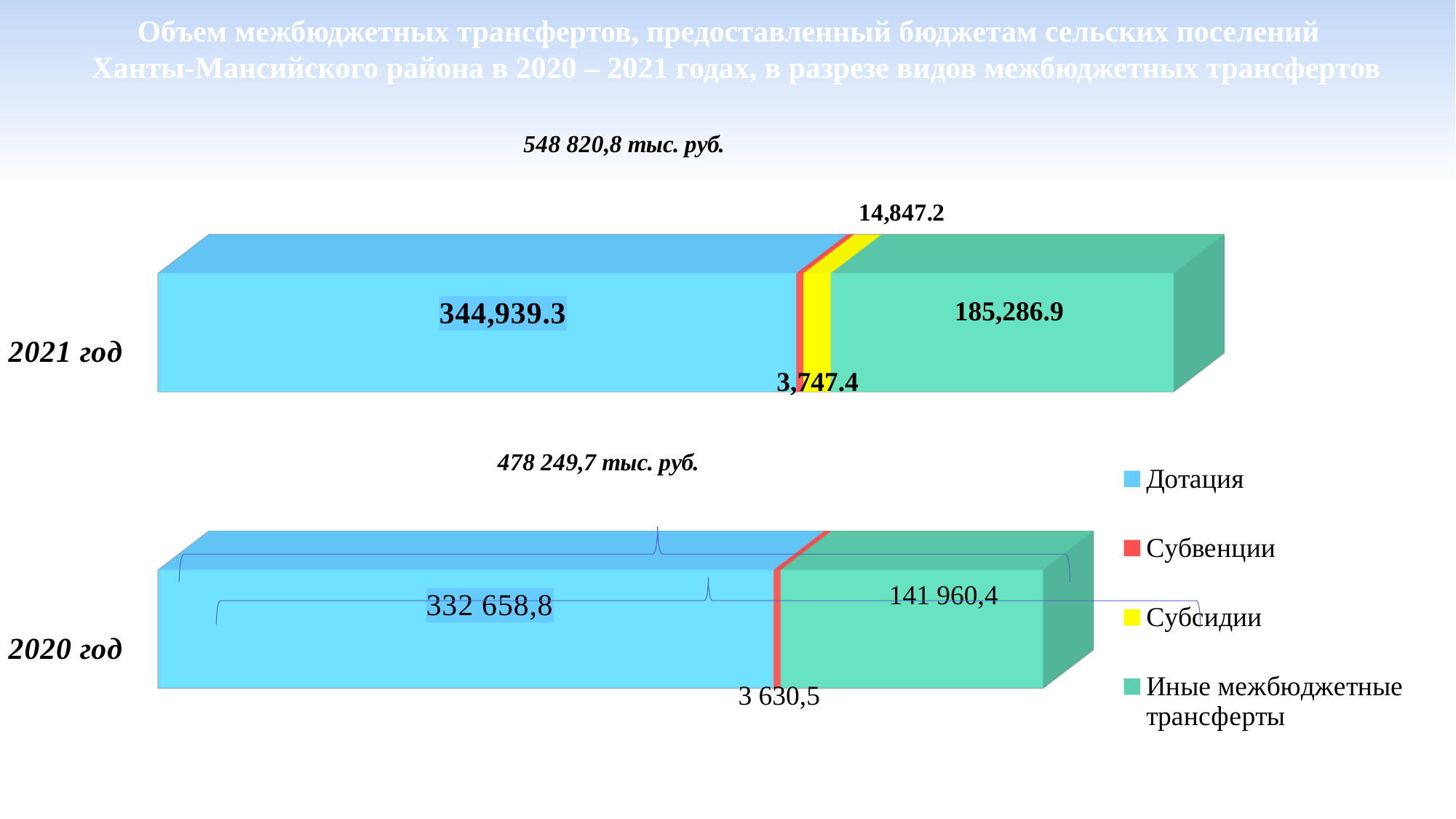
In the 2021 год chart, what is the value for Дотация? 344,939.3 How many series does the legend list? 4 In the 2020 год chart, what is the value for Субвенции? 3 630,5 Which is larger: Дотация in 2021 год or Дотация in 2020 год? Дотация in 2021 год In the 2020 год chart, what is the value for Иные межбюджетные трансферты? 141 960,4 What is the total of the 2020 год stacked bar? 478 249,7 тыс. руб. What kind of chart is used on this slide? Stacked bar chart In the 2021 год chart, what is the value for Субсидии? 14,847.2 In the 2021 год chart, which transfer type has the largest value? Дотация In the 2021 год chart, what is the difference between Дотация and Иные межбюджетные трансферты? 159,652.4 In the 2021 год chart, what is the value for Субвенции? 3,747.4 In the 2021 год chart, which transfer type has the smallest value? Субвенции